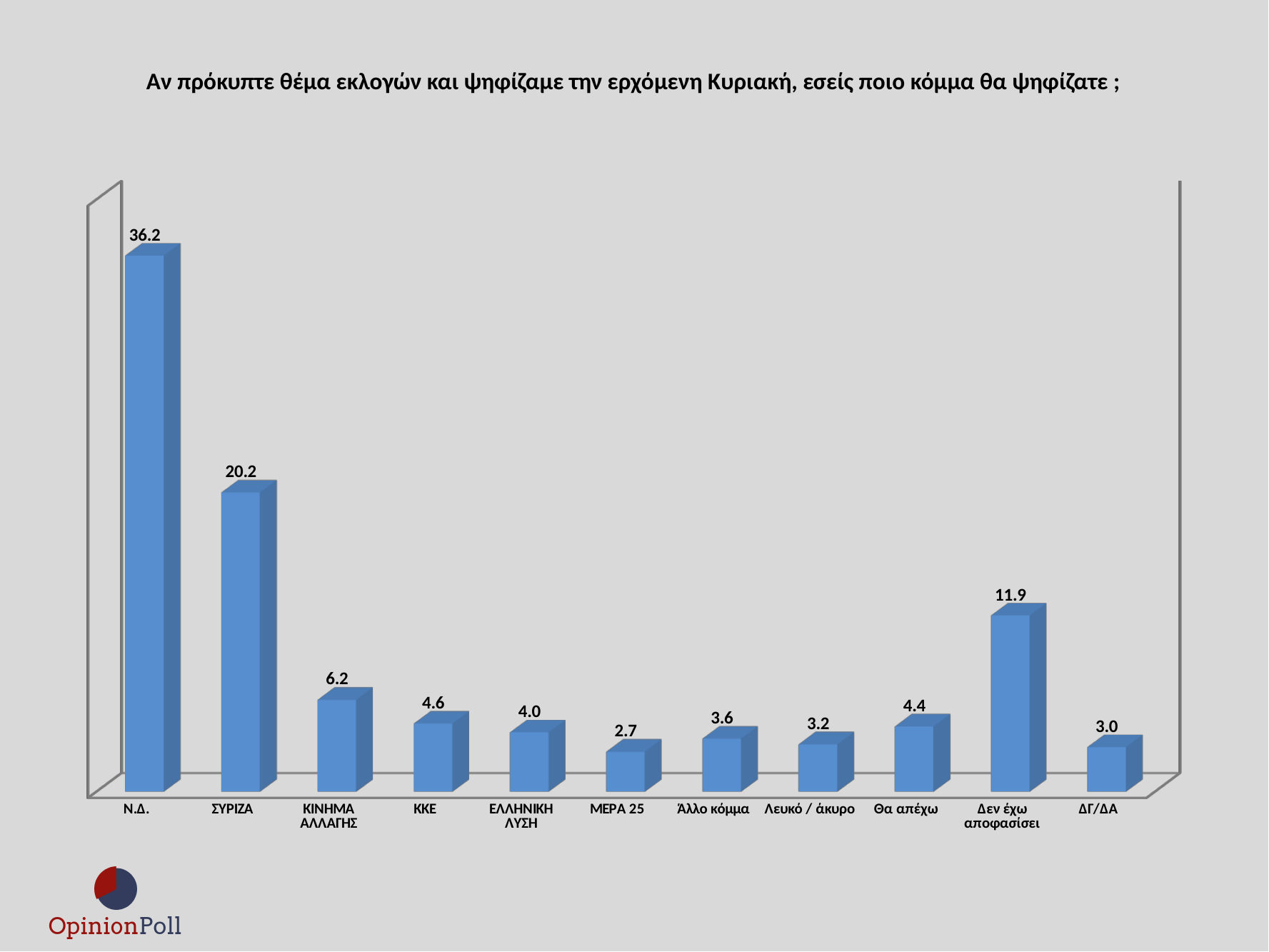
What is the value for Δεν έχω αποφασίσει? 11.9 What is the difference between the values for Ν.Δ. and ΣΥΡΙΖΑ? 16.0 What is the value for Ν.Δ.? 36.2 Which is larger, the value for ΚΙΝΗΜΑ ΑΛΛΑΓΗΣ or the value for ΕΛΛΗΝΙΚΗ ΛΥΣΗ? ΚΙΝΗΜΑ ΑΛΛΑΓΗΣ What is the value for ΣΥΡΙΖΑ? 20.2 Which category has the highest value? Ν.Δ. What colour are the bars in the chart? blue What kind of chart is shown on the slide? bar chart What is the difference between the values for Θα απέχω and Λευκό / άκυρο? 1.2 What is the value for ΚΚΕ? 4.6 How many categories are shown on the x axis? 11 Which category has the lowest value? ΜΕΡΑ 25